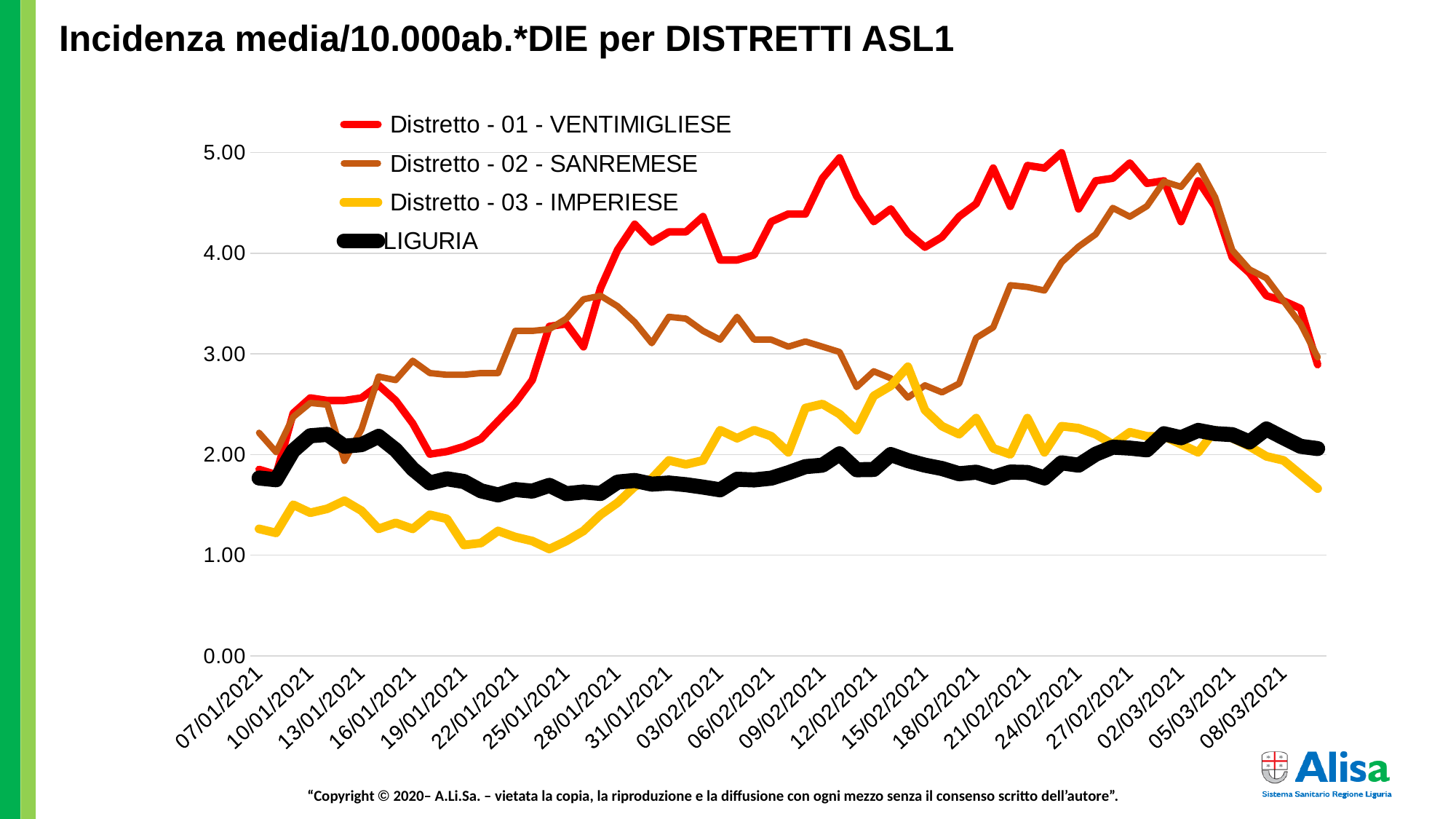
Does the Distretto - 02 - SANREMESE line rise or fall between 05/03/2021 and 08/03/2021? fall Is the value for Distretto - 02 - SANREMESE on 24/02/2021 greater or less than 3.00? greater Is the value for Distretto - 01 - VENTIMIGLIESE on 12/02/2021 greater or less than 4.00? greater Is the value for LIGURIA on 07/01/2021 greater or less than 2.00? less Which series has the lowest value on 25/01/2021? Distretto - 03 - IMPERIESE What colour is the LIGURIA line? black Which series reaches the highest value anywhere on the chart? Distretto - 01 - VENTIMIGLIESE What is the title of the chart? Incidenza media/10.000ab.*DIE per DISTRETTI ASL1 What kind of chart is shown on the slide? line chart On 12/02/2021, which is larger: Distretto - 01 - VENTIMIGLIESE or Distretto - 03 - IMPERIESE? Distretto - 01 - VENTIMIGLIESE How many series does the legend list? 4